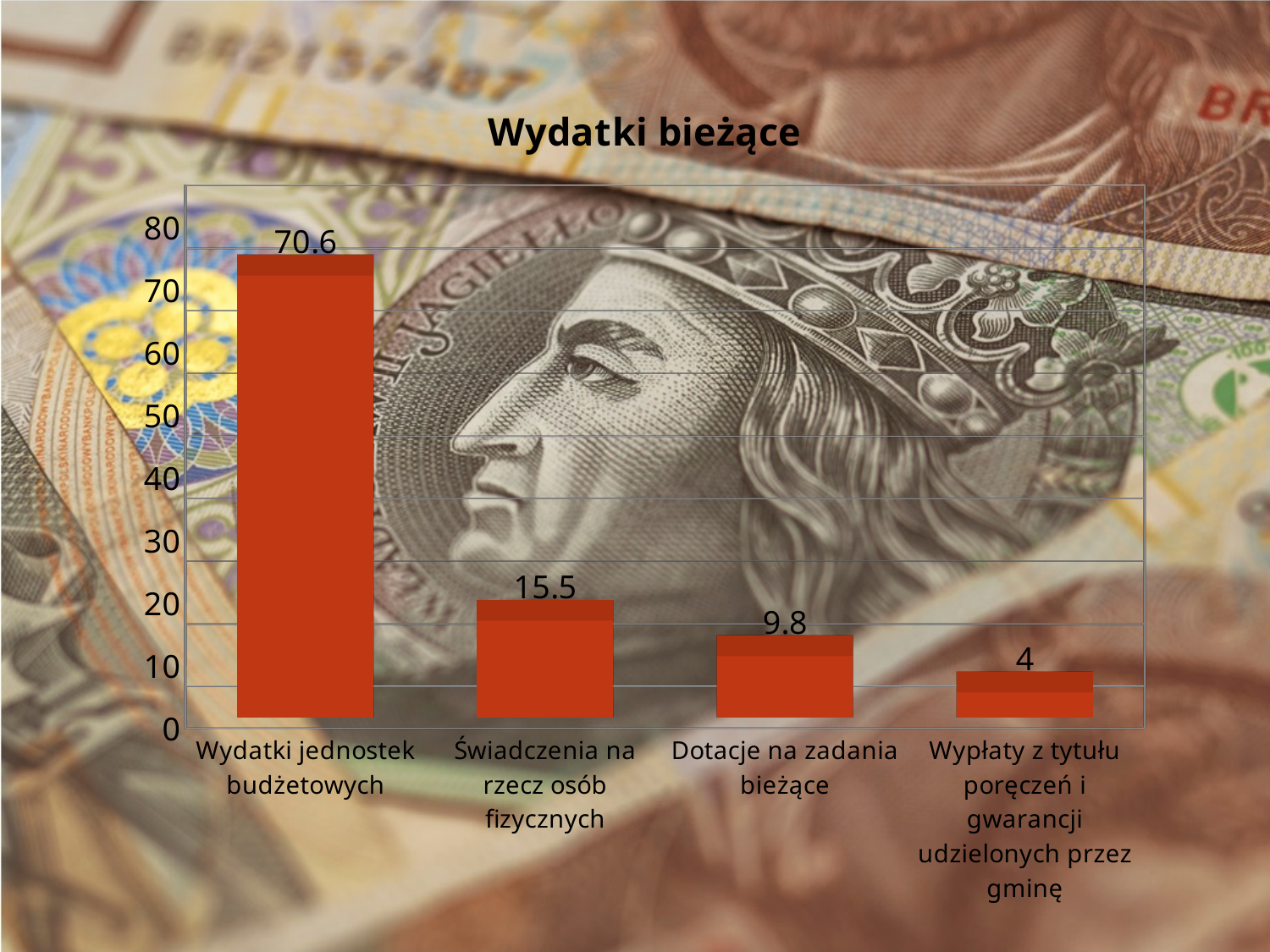
What is the difference between the values for Wydatki jednostek budżetowych and Świadczenia na rzecz osób fizycznych? 55.1 Which category has the lowest value? Wypłaty z tytułu poręczeń i gwarancji udzielonych przez gminę What kind of chart is shown on the slide? Bar chart What is the value for Dotacje na zadania bieżące? 9.8 What is the title of the chart? Wydatki bieżące Which is larger, the value for Świadczenia na rzecz osób fizycznych or the value for Dotacje na zadania bieżące? Świadczenia na rzecz osób fizycznych What is the difference between the values for Dotacje na zadania bieżące and Wypłaty z tytułu poręczeń i gwarancji udzielonych przez gminę? 5.8 What is the value for Świadczenia na rzecz osób fizycznych? 15.5 What is the value for Wypłaty z tytułu poręczeń i gwarancji udzielonych przez gminę? 4 Which category has the highest value? Wydatki jednostek budżetowych What is the value for Wydatki jednostek budżetowych? 70.6 How many categories are shown in the chart? 4